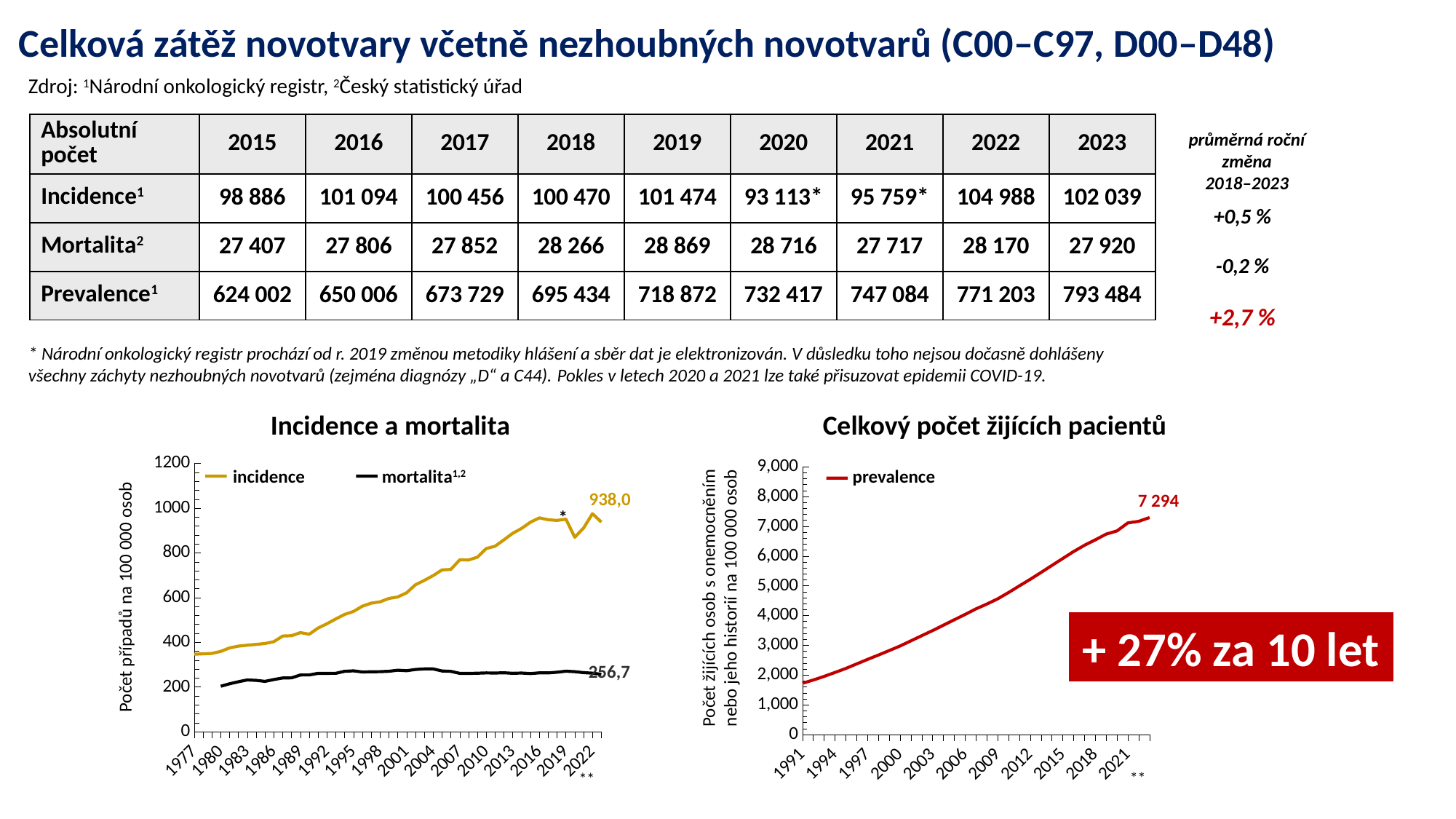
In the "Celkový počet žijících pacientů" chart, what is the labelled final value of the prevalence series? 7 294 In the "Incidence a mortalita" chart, which series has the higher final labelled value, incidence or mortalita? incidence In the "Incidence a mortalita" chart, what is the difference between the labelled final values of incidence and mortalita? 681,3 In the "Incidence a mortalita" chart, what is the labelled final value of the incidence series? 938,0 How many series does the legend of the "Celkový počet žijících pacientů" chart list? 1 What kind of chart is the "Incidence a mortalita" chart? line chart In the "Celkový počet žijících pacientů" chart, is the prevalence value in 1991 greater or less than 2,000? less In the "Incidence a mortalita" chart, does the incidence series generally rise or fall from 1977 to 2022? rise How many series does the legend of the "Incidence a mortalita" chart list? 2 In the "Incidence a mortalita" chart, what is the labelled final value of the mortalita series? 256,7 What text is shown in the red box on the "Celkový počet žijících pacientů" chart? + 27% za 10 let In the "Incidence a mortalita" chart, is the incidence value in 1977 greater or less than 400? less